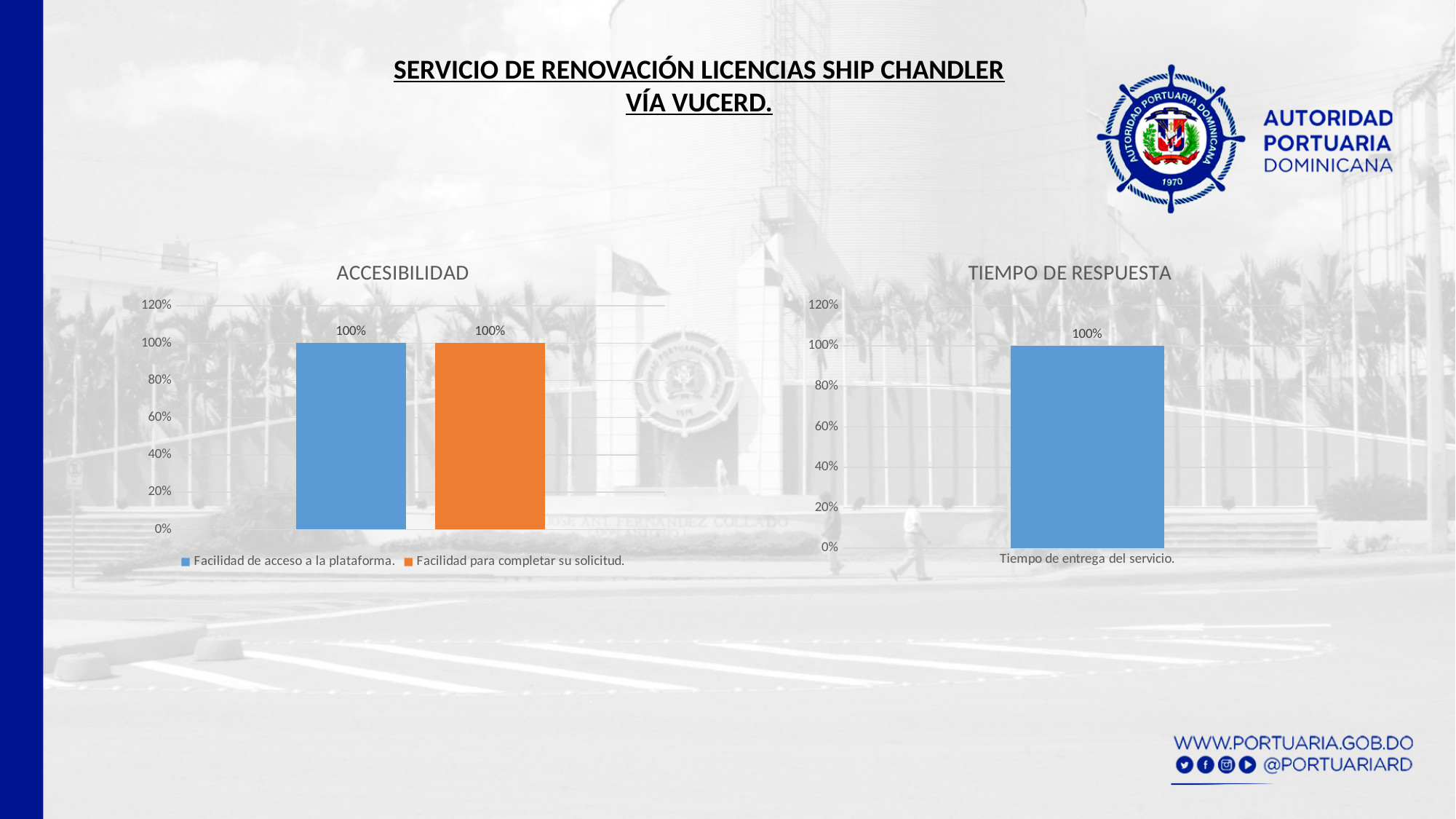
In the ACCESIBILIDAD chart, what is the value for Facilidad para completar su solicitud? 100% What kind of chart is the ACCESIBILIDAD chart? Bar chart In the ACCESIBILIDAD chart, what is the value for Facilidad de acceso a la plataforma? 100% In the ACCESIBILIDAD chart, what is the difference between the values for Facilidad de acceso a la plataforma and Facilidad para completar su solicitud? 0% How many bars are plotted in the TIEMPO DE RESPUESTA chart? 1 In the TIEMPO DE RESPUESTA chart, what is the value for Tiempo de entrega del servicio? 100% In the TIEMPO DE RESPUESTA chart, is the value for Tiempo de entrega del servicio greater or less than 80%? greater What is the title of the chart on the right side of the slide? TIEMPO DE RESPUESTA In the ACCESIBILIDAD chart, how many series does the legend list? 2 In the ACCESIBILIDAD chart, what colour is the bar for Facilidad para completar su solicitud? Orange In the ACCESIBILIDAD chart, is the value for Facilidad para completar su solicitud greater or less than 60%? greater What kind of chart is the TIEMPO DE RESPUESTA chart? Bar chart